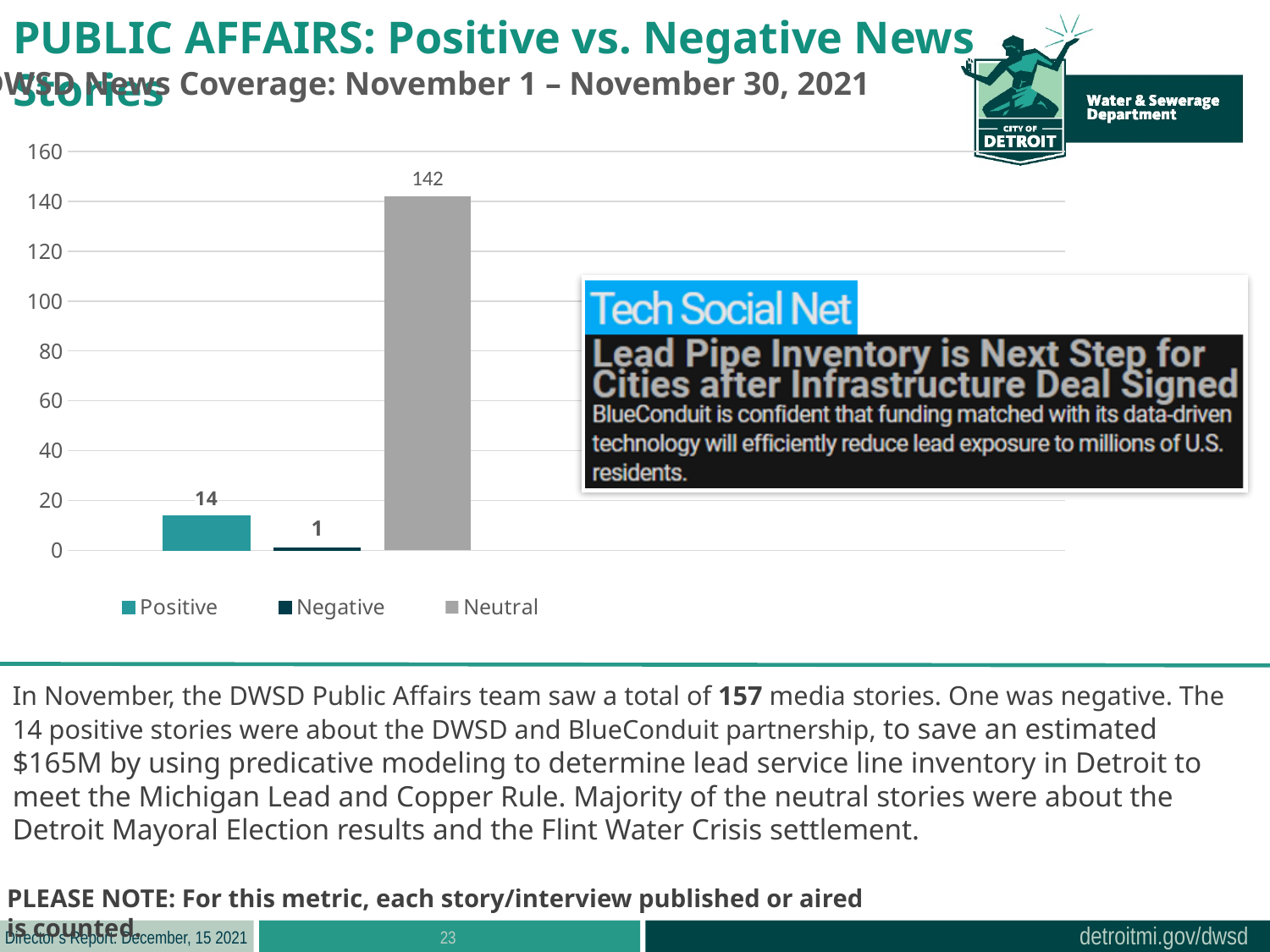
What colour is the Neutral bar? Gray Is the value for Neutral greater or less than 140? greater Which is larger, Positive or Negative? Positive How many series does the legend list? 3 What is the value for Negative news stories? 1 What is the value for Neutral news stories? 142 What is the difference between the Neutral and Positive values? 128 Which category has the highest value? Neutral What is the difference between the Positive and Negative values? 13 What is the value for Positive news stories? 14 What kind of chart is shown? Bar chart Which category has the lowest value? Negative